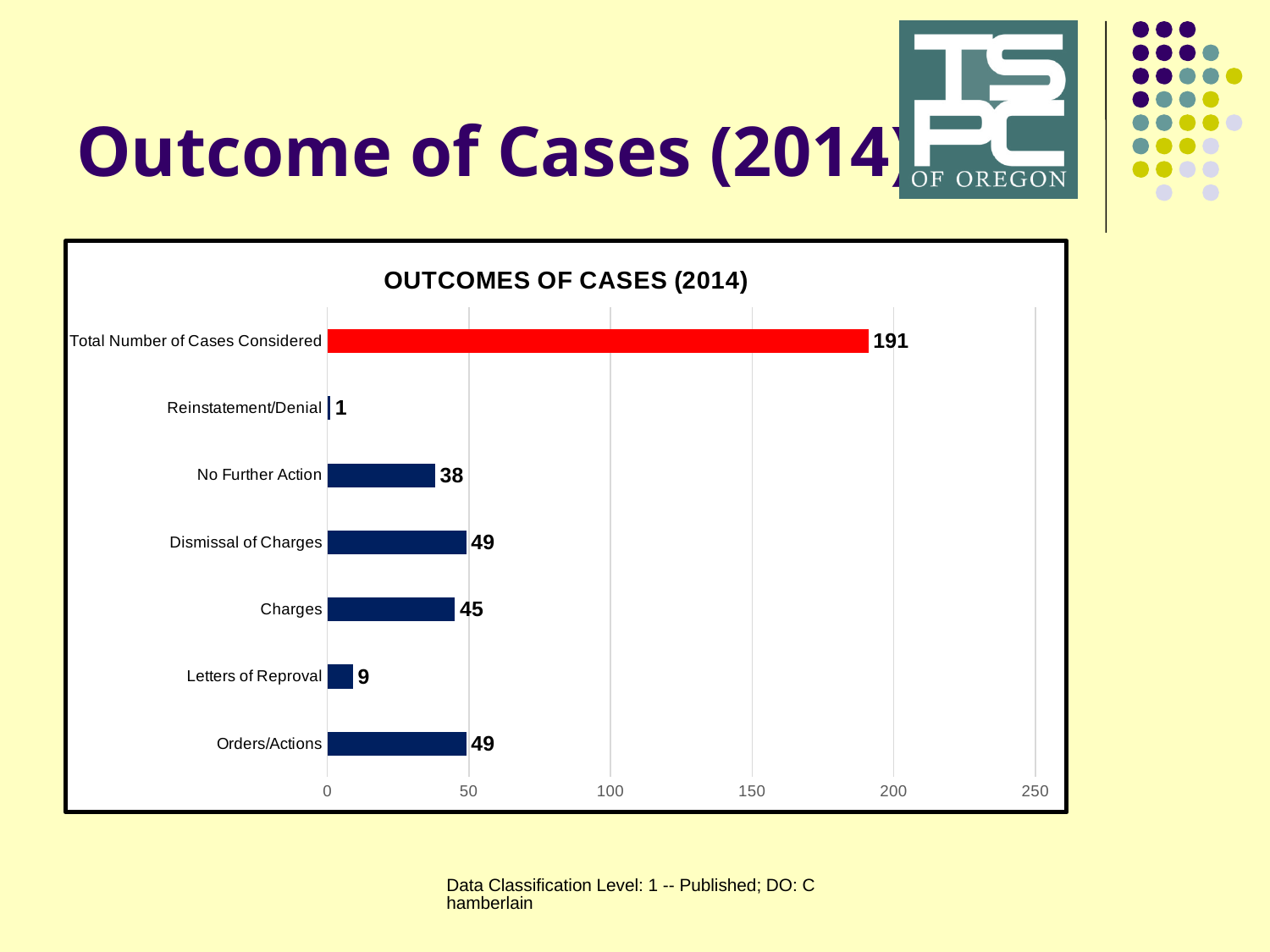
What is the title of the chart? OUTCOMES OF CASES (2014) What kind of chart is shown on the slide? Bar chart Which category has the highest value? Total Number of Cases Considered Which bar is coloured red? Total Number of Cases Considered Which is larger, Charges or Orders/Actions? Orders/Actions What is the value for No Further Action? 38 Which category has the lowest value? Reinstatement/Denial What is the value for Letters of Reproval? 9 How many categories are shown in the chart? 7 What is the value for Total Number of Cases Considered? 191 What is the difference between Dismissal of Charges and No Further Action? 11 What is the value for Charges? 45